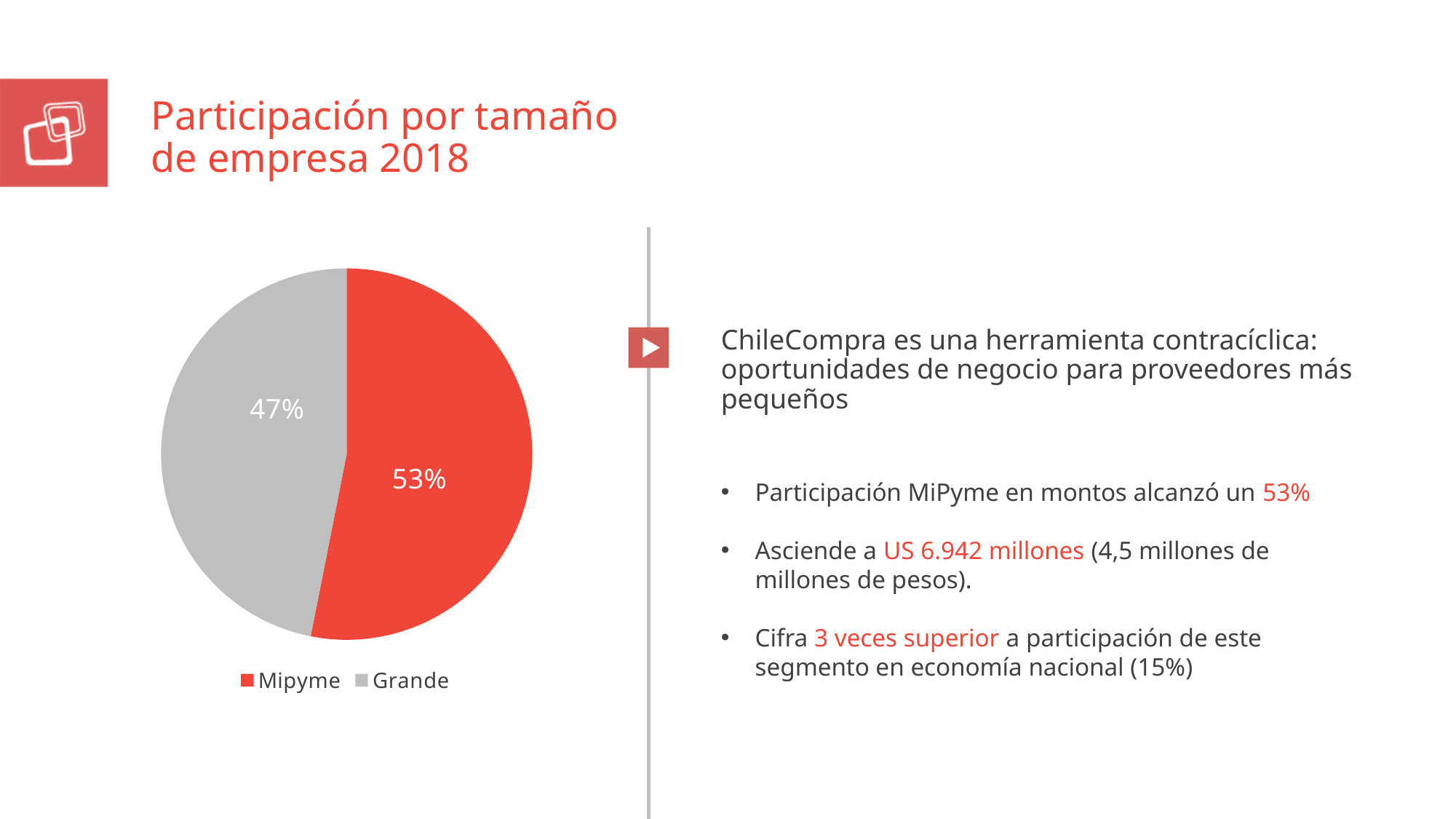
What share of the pie does Mipyme have? 53% What colour is the Mipyme slice? red Is the value for Grande greater or less than 50%? less What colour is the Grande slice? grey Which category has the largest slice of the pie? Mipyme What share of the pie does Grande have? 47% What kind of chart is shown on the slide? pie chart How many slices does the pie chart have? 2 Which category has the smallest slice of the pie? Grande How many entries does the legend list? 2 What is the difference in percentage points between the Mipyme and Grande slices? 6 Which slice is larger, Mipyme or Grande? Mipyme